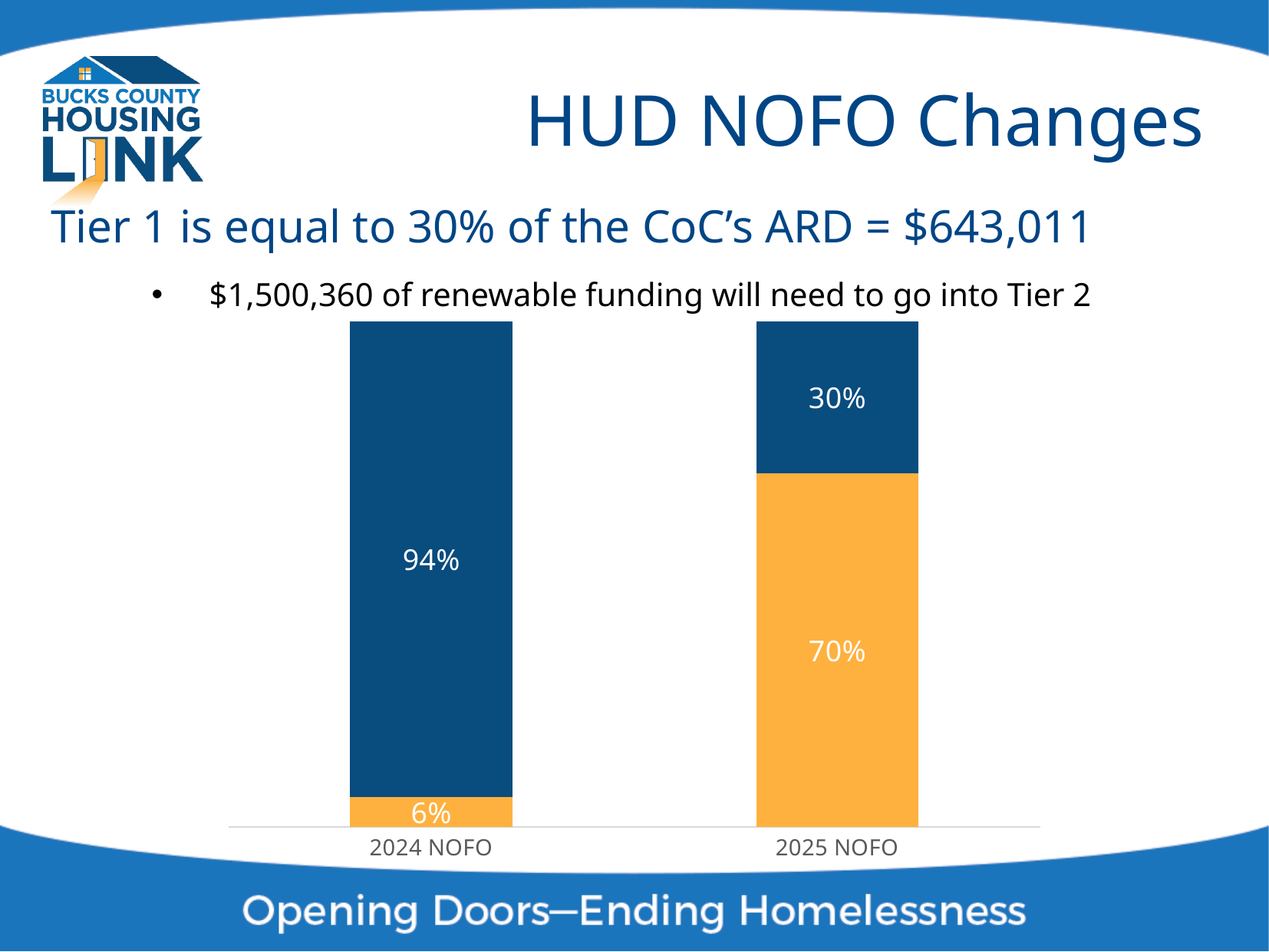
What are the two category labels on the x axis of the chart? 2024 NOFO and 2025 NOFO What is the value of the dark blue segment for 2024 NOFO? 94% Which category has the larger dark blue segment, 2024 NOFO or 2025 NOFO? 2024 NOFO What is the value of the orange segment for 2025 NOFO? 70% What is the value of the dark blue segment for 2025 NOFO? 30% How many categories are shown on the x axis of the chart? 2 Does the orange segment rise or fall from 2024 NOFO to 2025 NOFO? Rise What is the difference between the orange segment values for 2025 NOFO and 2024 NOFO? 64% What is the total of the stacked bar for 2024 NOFO? 100% What is the value of the orange segment for 2024 NOFO? 6% Which category has the larger orange segment, 2024 NOFO or 2025 NOFO? 2025 NOFO What kind of chart is shown on the slide? Stacked bar chart